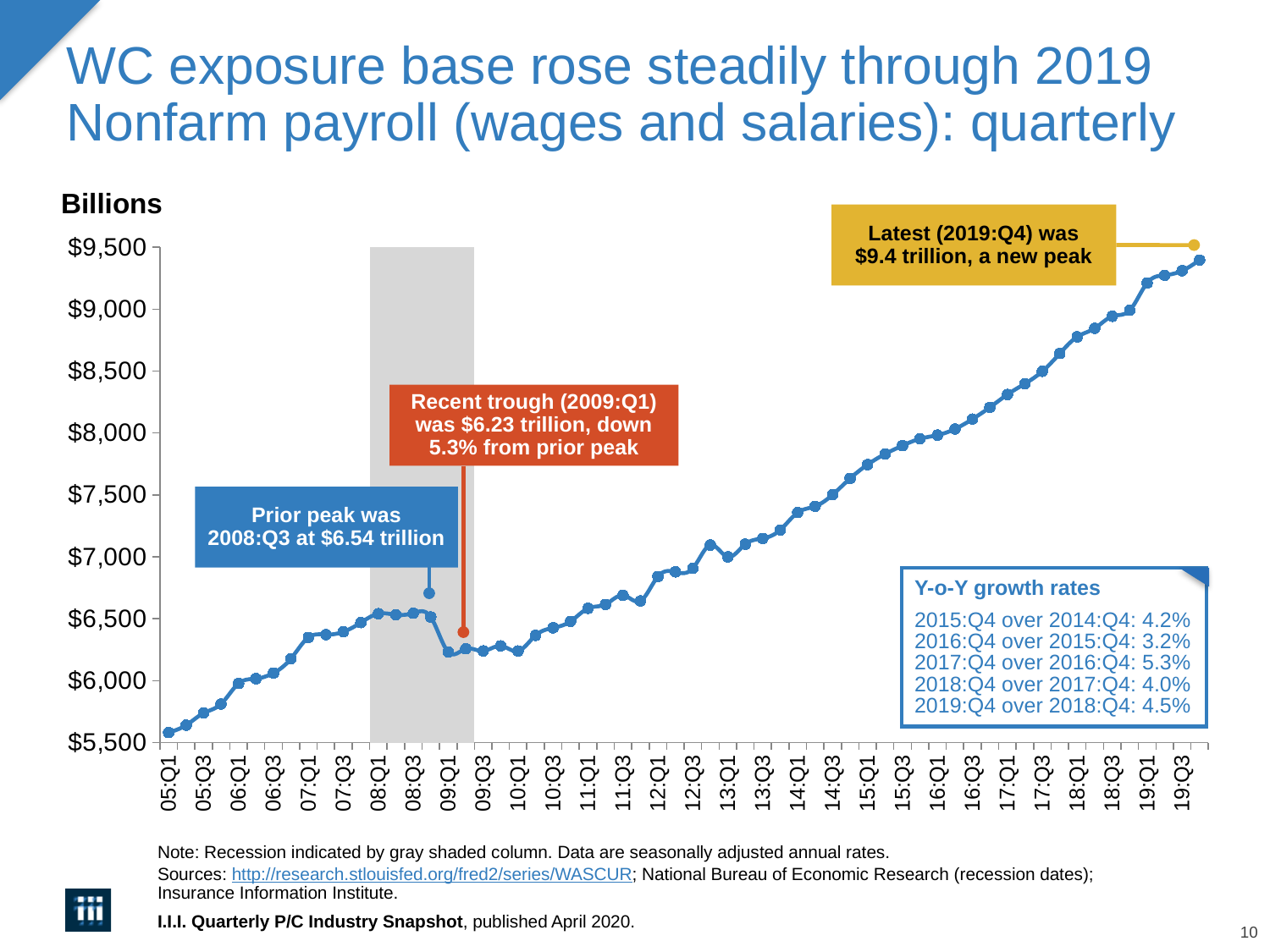
What kind of chart is shown on the slide? line chart Is the value for 05:Q1 greater or less than $6,000? less What was the latest value (2019:Q4) according to the callout? $9.4 trillion Overall, do the values rise or fall from 05:Q1 to 19:Q4? rise According to the callout, what was the value at the recent trough in 2009:Q1? $6.23 trillion Which quarter has the highest value on the chart? 2019:Q4 Which quarter has the lowest value on the chart? 05:Q1 Which year-over-year growth rate listed in the box is the highest? 2017:Q4 over 2016:Q4: 5.3% Is the value for 19:Q3 greater or less than $9,000? greater According to the callout, what was the value of nonfarm payroll at the prior peak in 2008:Q3? $6.54 trillion What unit is indicated above the y-axis of the chart? Billions By how much did the value fall from the prior peak (2008:Q3) to the recent trough (2009:Q1), using the callout values? $0.31 trillion